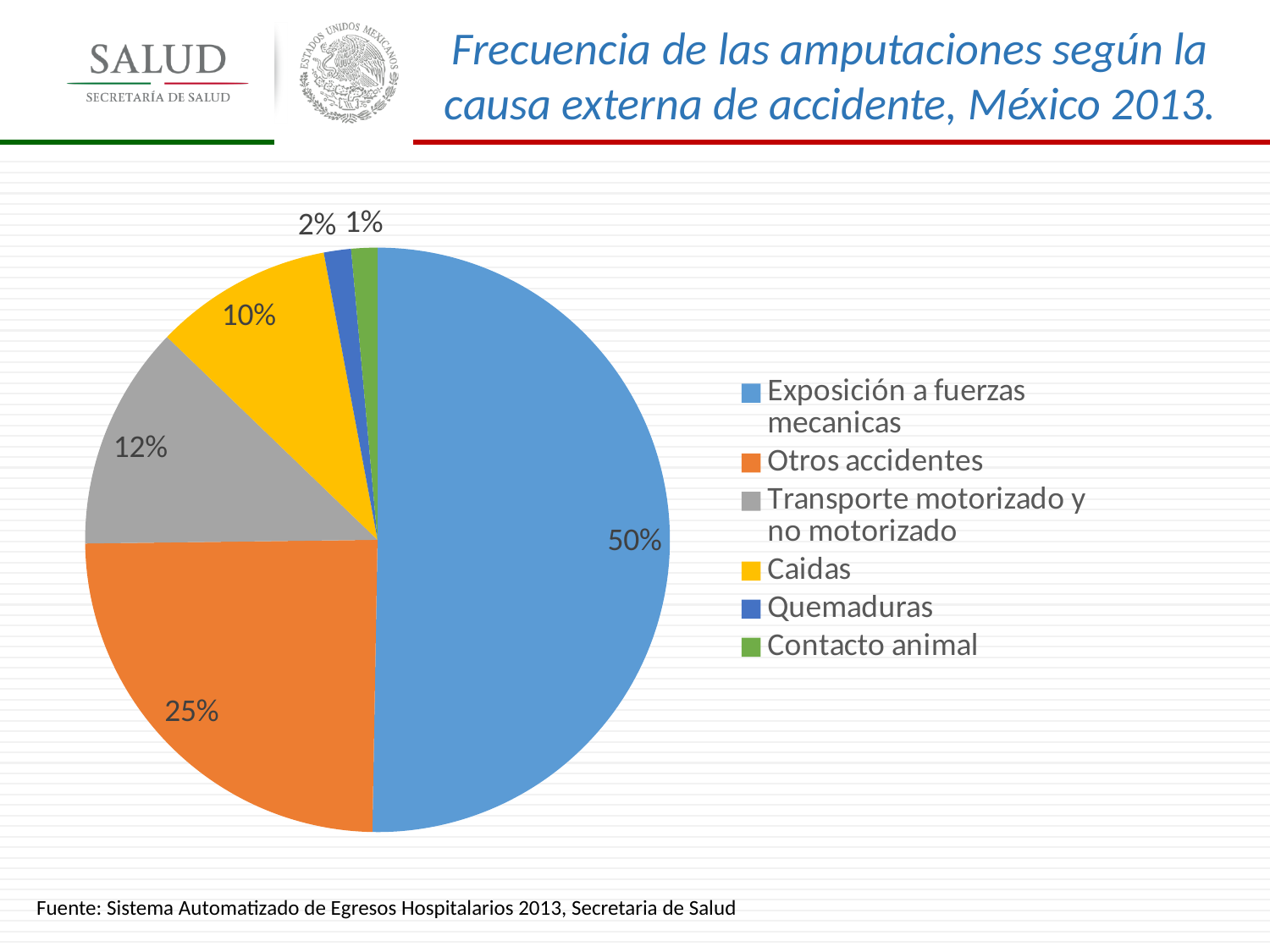
How many categories does the pie chart show? 6 What percentage is shown for Transporte motorizado y no motorizado? 12% What percentage is shown for Caidas? 10% Which is larger, the slice for Caidas or the slice for Transporte motorizado y no motorizado? Transporte motorizado y no motorizado What share of the pie does Exposición a fuerzas mecanicas represent? 50% What is the difference in percentage points between Exposición a fuerzas mecanicas and Otros accidentes? 25 What colour is the slice for Caidas? Yellow Which category has the largest slice of the pie? Exposición a fuerzas mecanicas Which category has the smallest slice of the pie? Contacto animal What percentage is shown for Quemaduras? 2% What kind of chart is shown on the slide? Pie chart What is the value shown for Otros accidentes? 25%